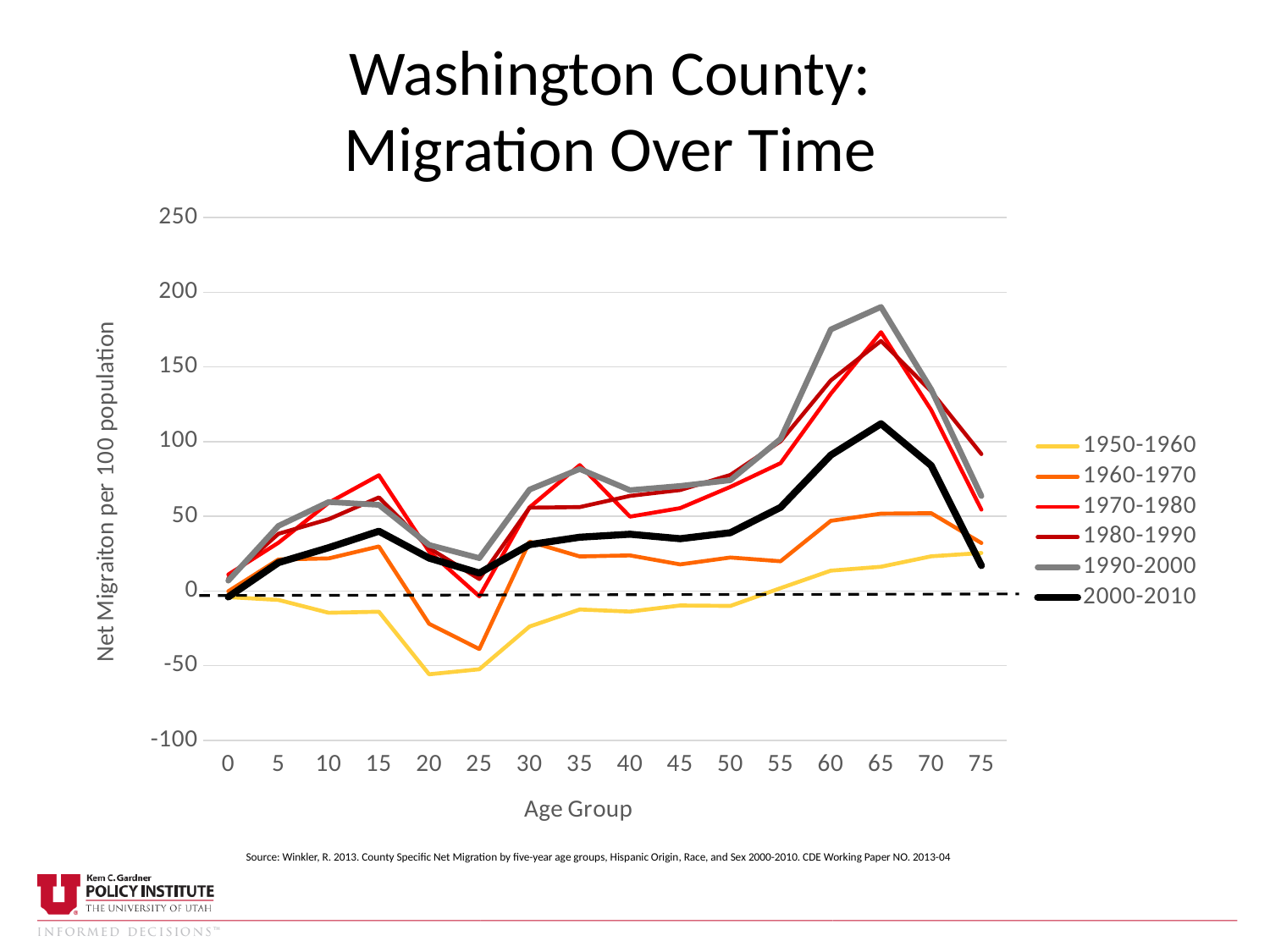
What kind of chart is shown on the slide? line chart Is the value for the 2000-2010 series at age group 65 greater or less than 100? greater At age group 65, which series has the larger value: 1990-2000 or 2000-2010? 1990-2000 Which series has the lowest value at age group 20? 1950-1960 Does the 1950-1960 series rise or fall between age group 20 and age group 65? rise Is the value for the 1950-1960 series at age group 20 greater or less than -50? less How many age groups are plotted along the x axis? 16 What is the title of the x axis? Age Group Is the value for the 1990-2000 series at age group 65 greater or less than 150? greater Which series reaches the lowest net migration value on the chart? 1950-1960 How many series does the legend list? 6 Which series reaches the highest net migration value on the chart? 1990-2000